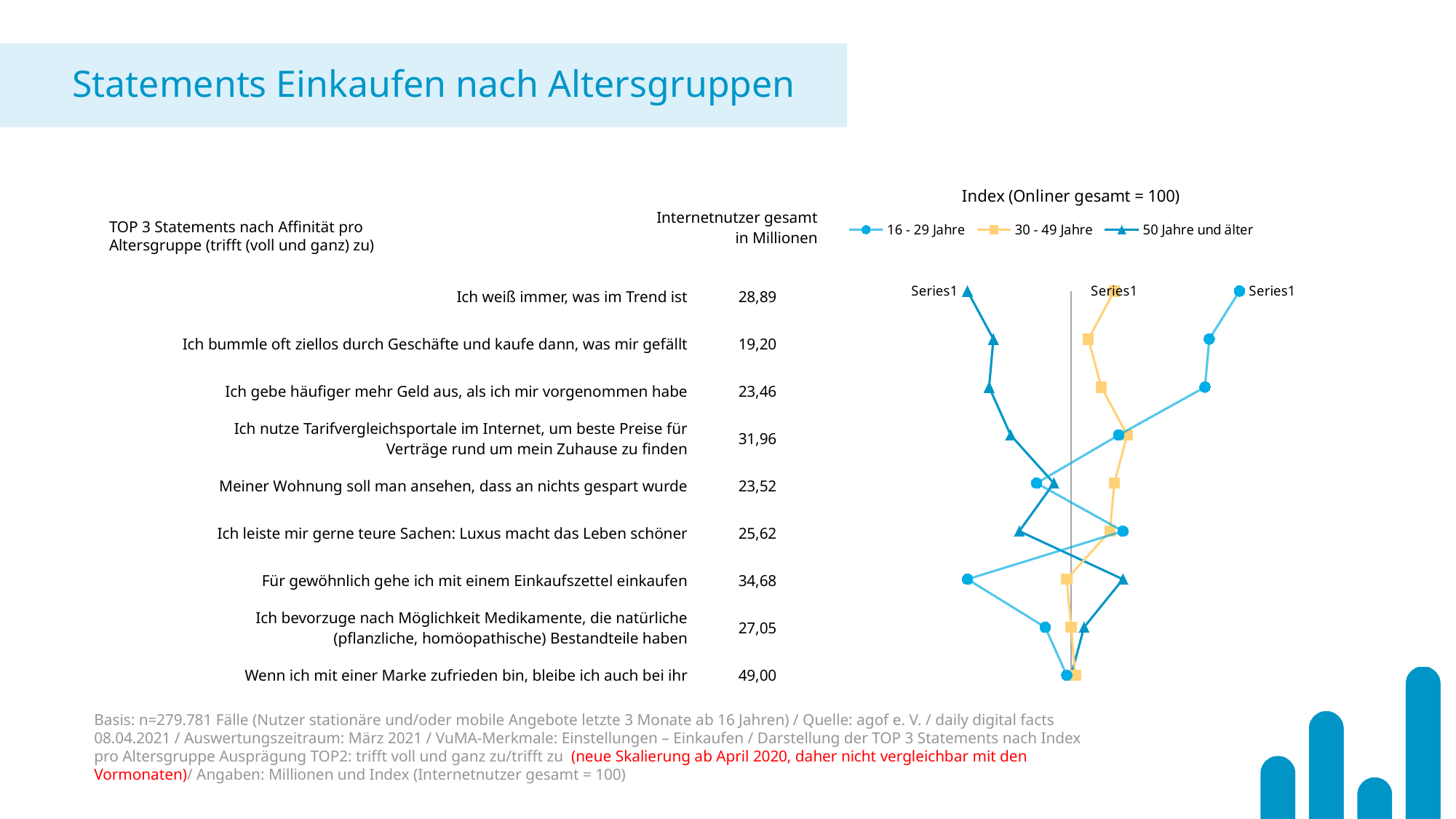
For the statement "Für gewöhnlich gehe ich mit einem Einkaufszettel einkaufen", which has the higher index: 16 - 29 Jahre or 50 Jahre und älter? 50 Jahre und älter For the statement "Ich weiß immer, was im Trend ist", which age group has the lowest index? 50 Jahre und älter What is the value of Internetnutzer gesamt in Millionen for "Ich nutze Tarifvergleichsportale im Internet, um beste Preise für Verträge rund um mein Zuhause zu finden"? 31,96 For the statement "Ich weiß immer, was im Trend ist", is the index for 16 - 29 Jahre greater or less than 100? greater Which age groups are listed in the chart legend? 16 - 29 Jahre, 30 - 49 Jahre, 50 Jahre und älter What kind of chart is shown on the slide? line chart How many statements (categories) are plotted in the chart? 9 How many series does the chart legend list? 3 What is the value of Internetnutzer gesamt in Millionen for "Wenn ich mit einer Marke zufrieden bin, bleibe ich auch bei ihr"? 49,00 Which statement has the lowest value of Internetnutzer gesamt in Millionen? Ich bummle oft ziellos durch Geschäfte und kaufe dann, was mir gefällt What is the difference in Internetnutzer gesamt in Millionen between "Wenn ich mit einer Marke zufrieden bin, bleibe ich auch bei ihr" and "Ich bummle oft ziellos durch Geschäfte und kaufe dann, was mir gefällt"? 29,80 For the statement "Ich weiß immer, was im Trend ist", which age group has the highest index? 16 - 29 Jahre